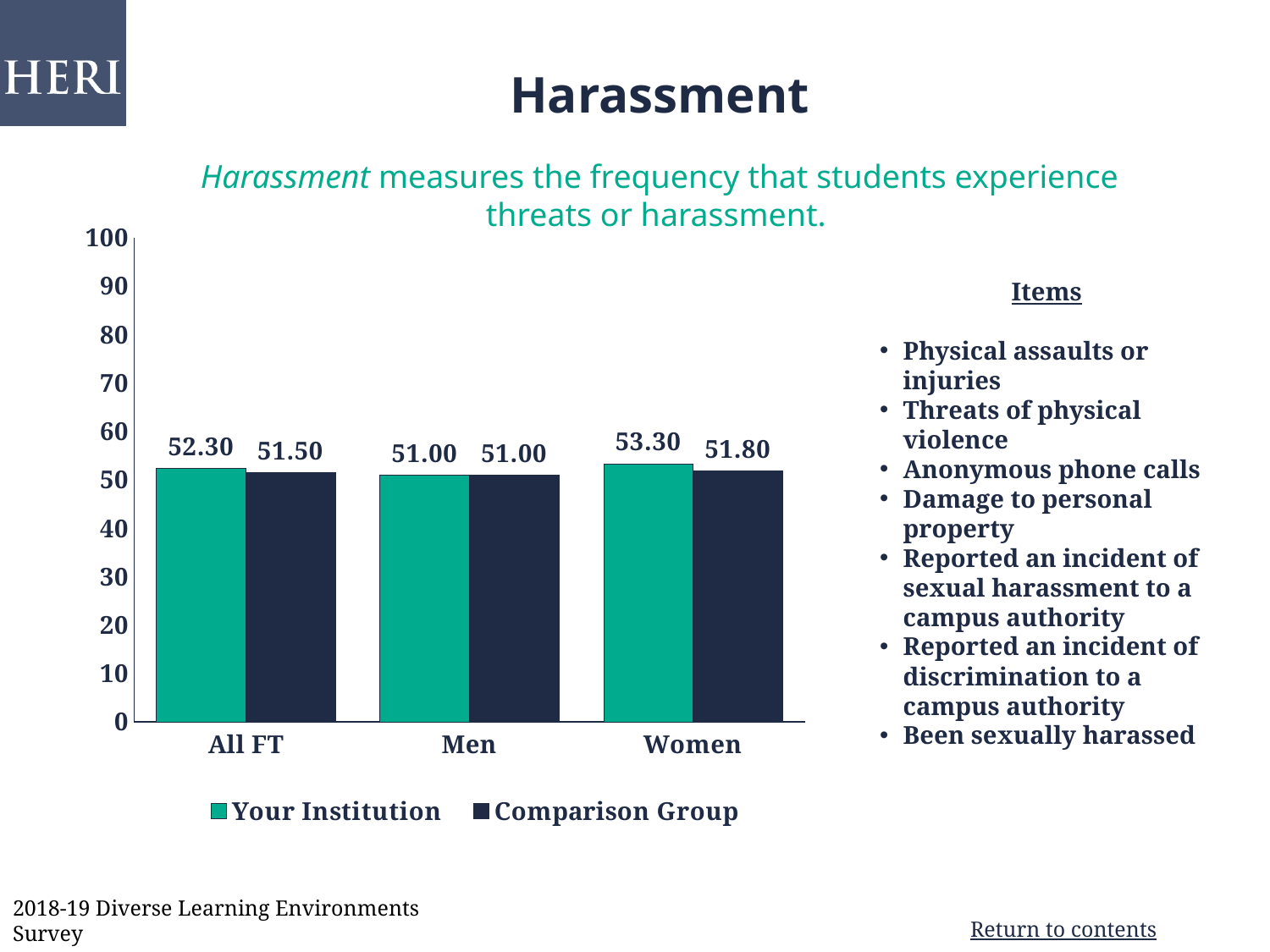
What is the value for Comparison Group in the Women category? 51.80 Which category has the lowest value for Comparison Group? Men Is the value for Your Institution in the Women category greater or less than 60? less Which category has the highest value for Your Institution? Women How many categories are shown on the x axis? 3 What kind of chart is shown on the slide? bar chart What is the value for Your Institution in the All FT category? 52.30 What is the value for Your Institution in the Men category? 51.00 Which is larger in the Women category, Your Institution or Comparison Group? Your Institution How many series does the legend list? 2 What is the difference between Your Institution and Comparison Group in the Women category? 1.50 What is the difference between Your Institution and Comparison Group in the All FT category? 0.80